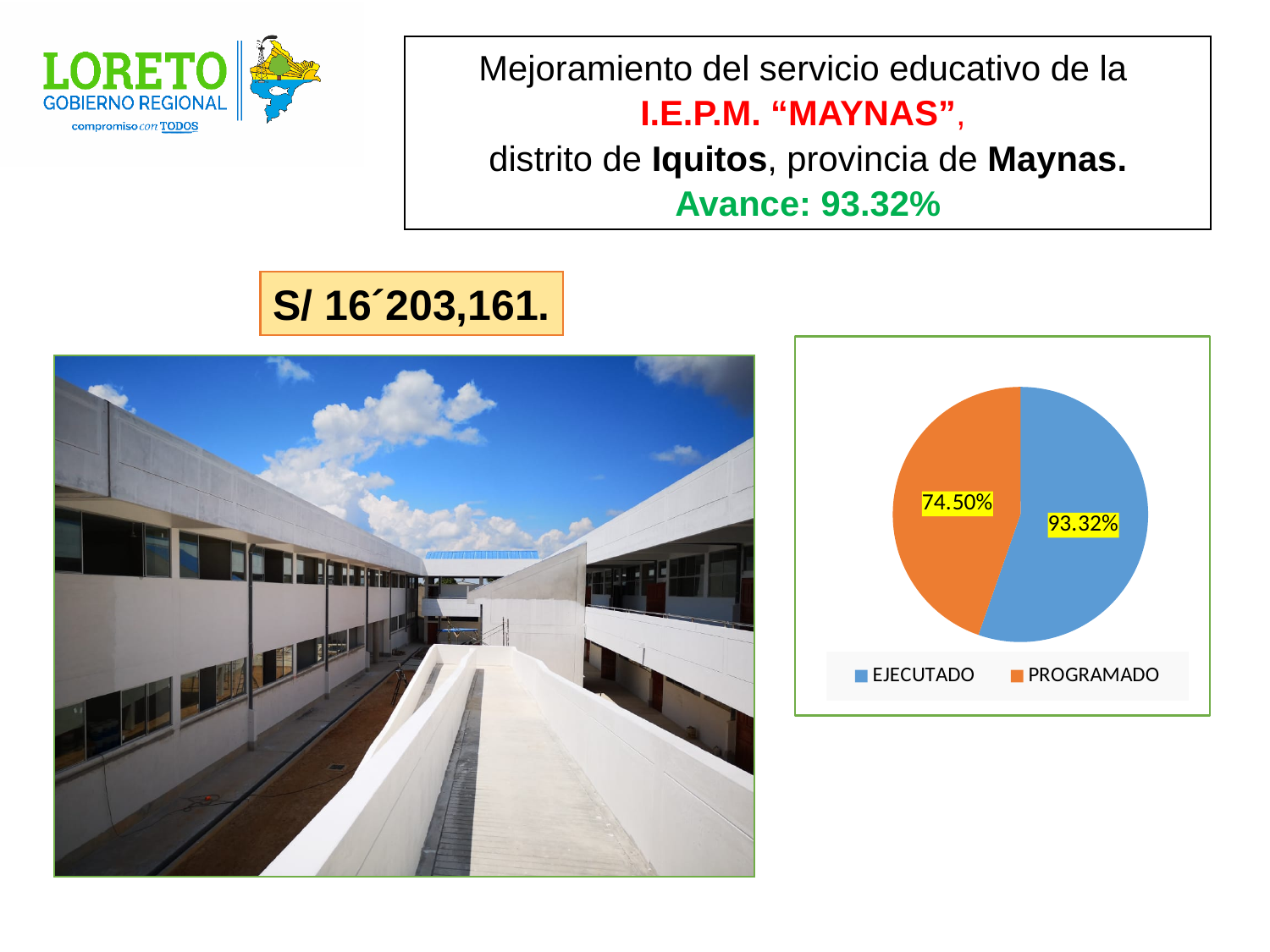
In the pie chart, what value is shown for EJECUTADO? 93.32% Which slice of the pie chart has the larger labelled value? EJECUTADO What value is printed on the blue slice of the pie chart? 93.32% How many slices does the pie chart have? 2 What colour is the EJECUTADO slice in the pie chart? blue In the pie chart, is the value for EJECUTADO larger or smaller than the value for PROGRAMADO? larger In the pie chart, what value is shown for PROGRAMADO? 74.50% What colour is the PROGRAMADO slice in the pie chart? orange Which slice of the pie chart has the smaller labelled value? PROGRAMADO What is the difference between the labelled values for EJECUTADO and PROGRAMADO in the pie chart? 18.82 percentage points How many entries does the legend of the pie chart list? 2 What kind of chart is shown on the right side of the slide? pie chart